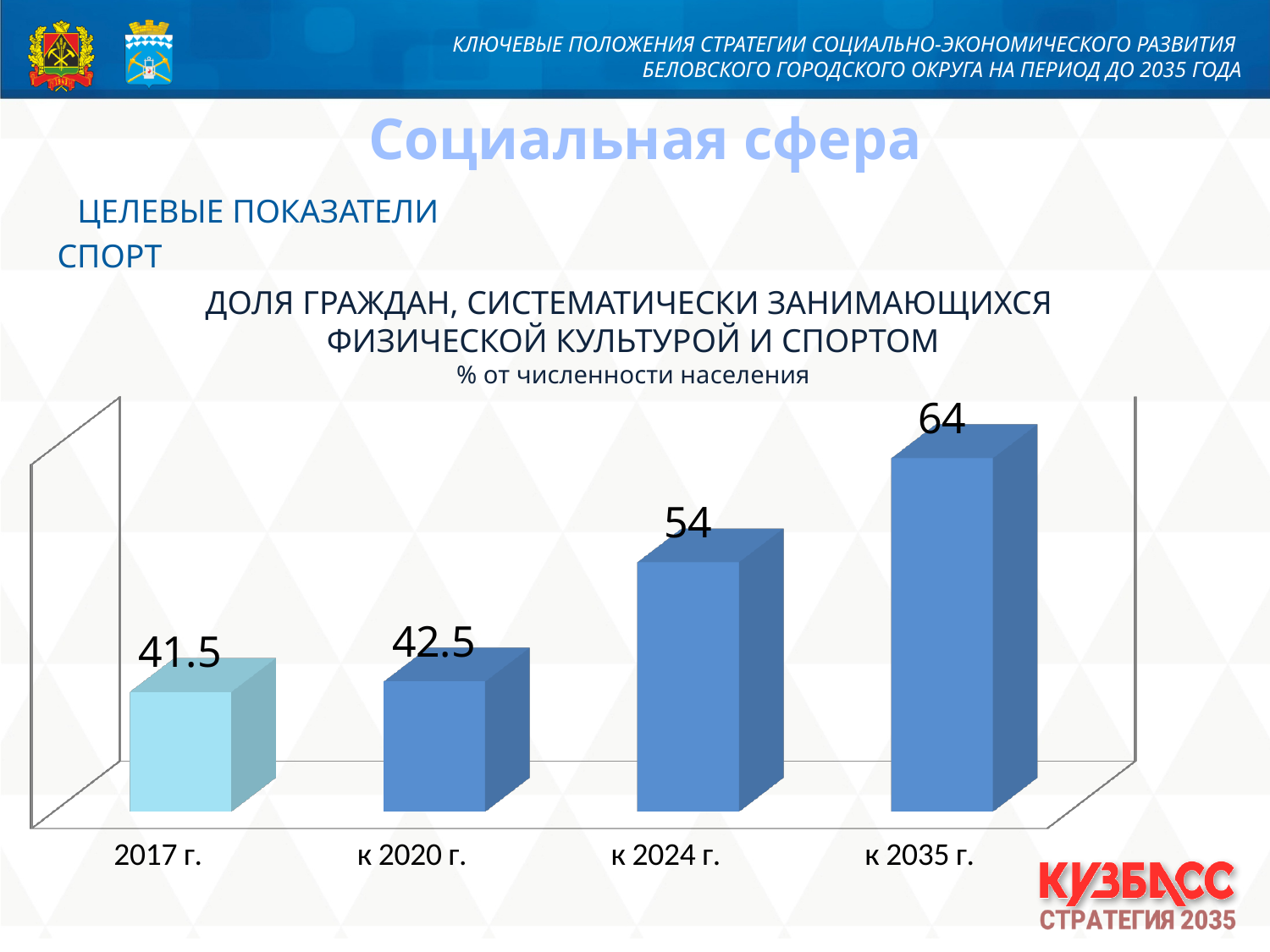
Which category has the highest value? к 2035 г. Which category has the lowest value? 2017 г. What is the value for к 2035 г.? 64 What is the value for 2017 г.? 41.5 How many categories are shown on the chart? 4 Do the values rise or fall from 2017 г. to к 2035 г.? rise What kind of chart is shown on the slide? bar chart What is the value for к 2020 г.? 42.5 Which is larger, the value for к 2024 г. or the value for к 2020 г.? к 2024 г. What is the difference between the values for к 2035 г. and 2017 г.? 22.5 What is the difference between the values for к 2024 г. and к 2020 г.? 11.5 What is the value for к 2024 г.? 54